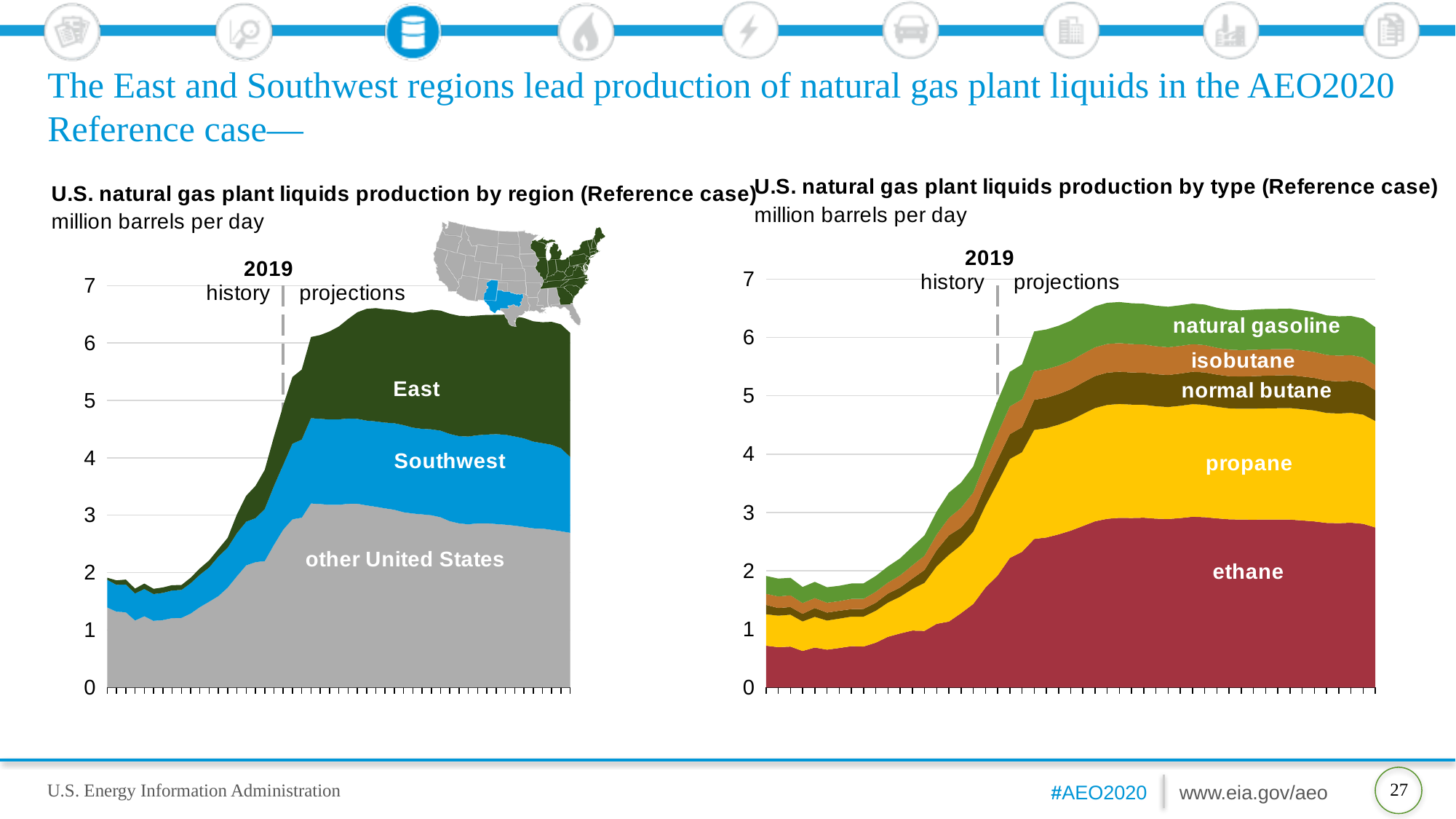
In the left chart by region, which region accounts for the largest share of production in the projection period? other United States In the right chart by type, is ethane production at the end of the projection period greater or less than 3 million barrels per day? less How many product types are shown as series in the right chart, 'U.S. natural gas plant liquids production by type'? 5 What kind of chart is the left chart, 'U.S. natural gas plant liquids production by region (Reference case)'? stacked area chart In the right chart by type, which product type accounts for the largest share of production in the projection period? ethane In the right chart by type, is propane production larger or smaller than isobutane production in the projection period? larger What unit of measurement is used on the y axis of both charts? million barrels per day In the left chart by region, is total production at the end of the projection period greater or less than 6 million barrels per day? greater In the right chart by type, does total natural gas plant liquids production rise or fall from the start of the history period to the projection period? rise What year marks the boundary between history and projections in both charts? 2019 How many regions are shown as series in the left chart, 'U.S. natural gas plant liquids production by region'? 3